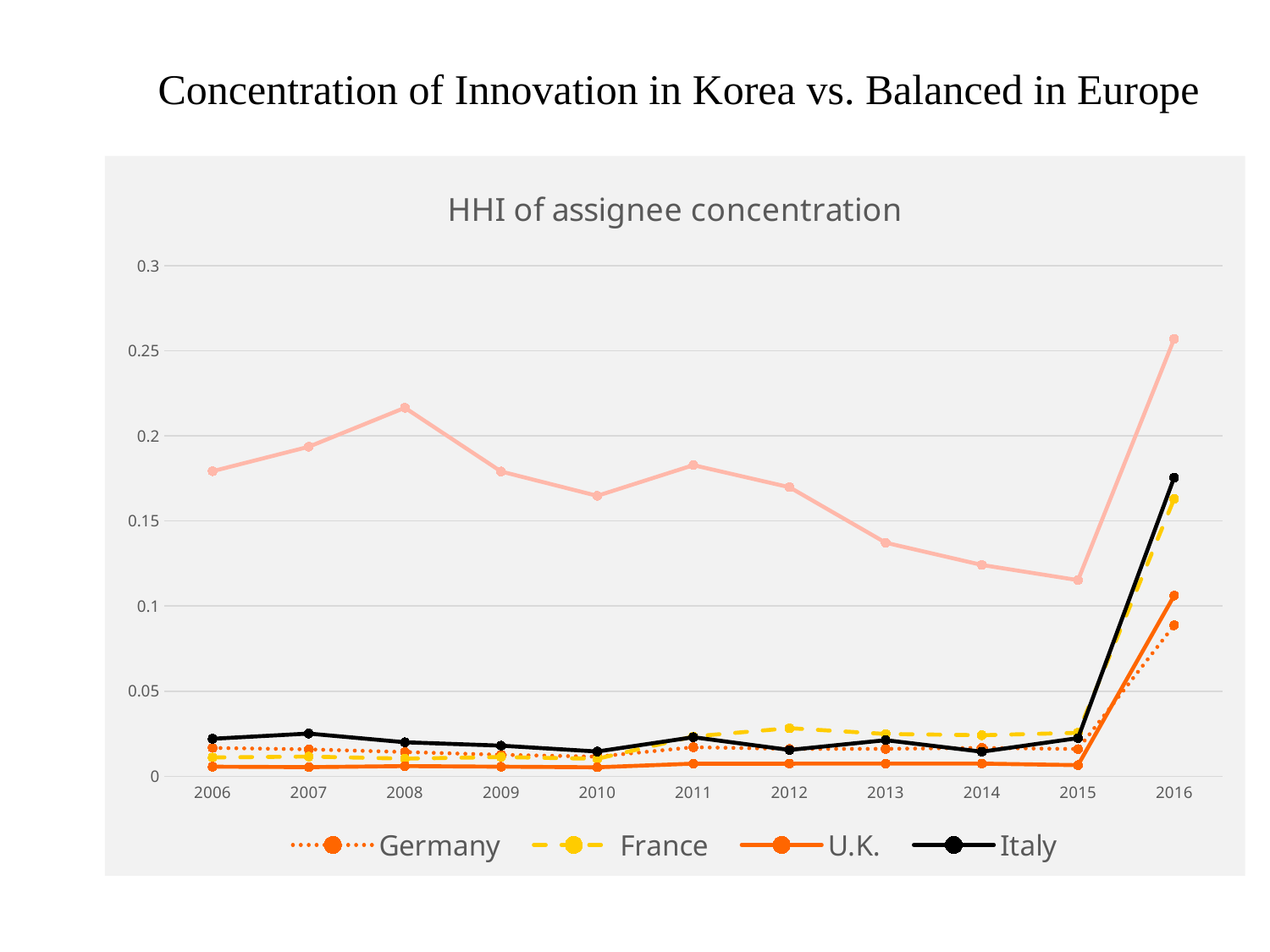
Is the value for U.K. in 2016 greater or less than 0.15? less Is the value for Italy in 2016 greater or less than 0.15? greater Is the value for Germany in 2016 greater or less than 0.1? less In 2016, which is larger: the value for Italy or the value for U.K.? Italy How many years are shown on the x axis of the chart? 11 How many series does the chart's legend list? 4 Which series in the legend has the lowest value in 2016? Germany What is the title of the chart? HHI of assignee concentration Does the Italy line rise or fall from 2015 to 2016? rise What kind of chart is shown on the slide? line chart Which series in the legend has the highest value in 2016? Italy